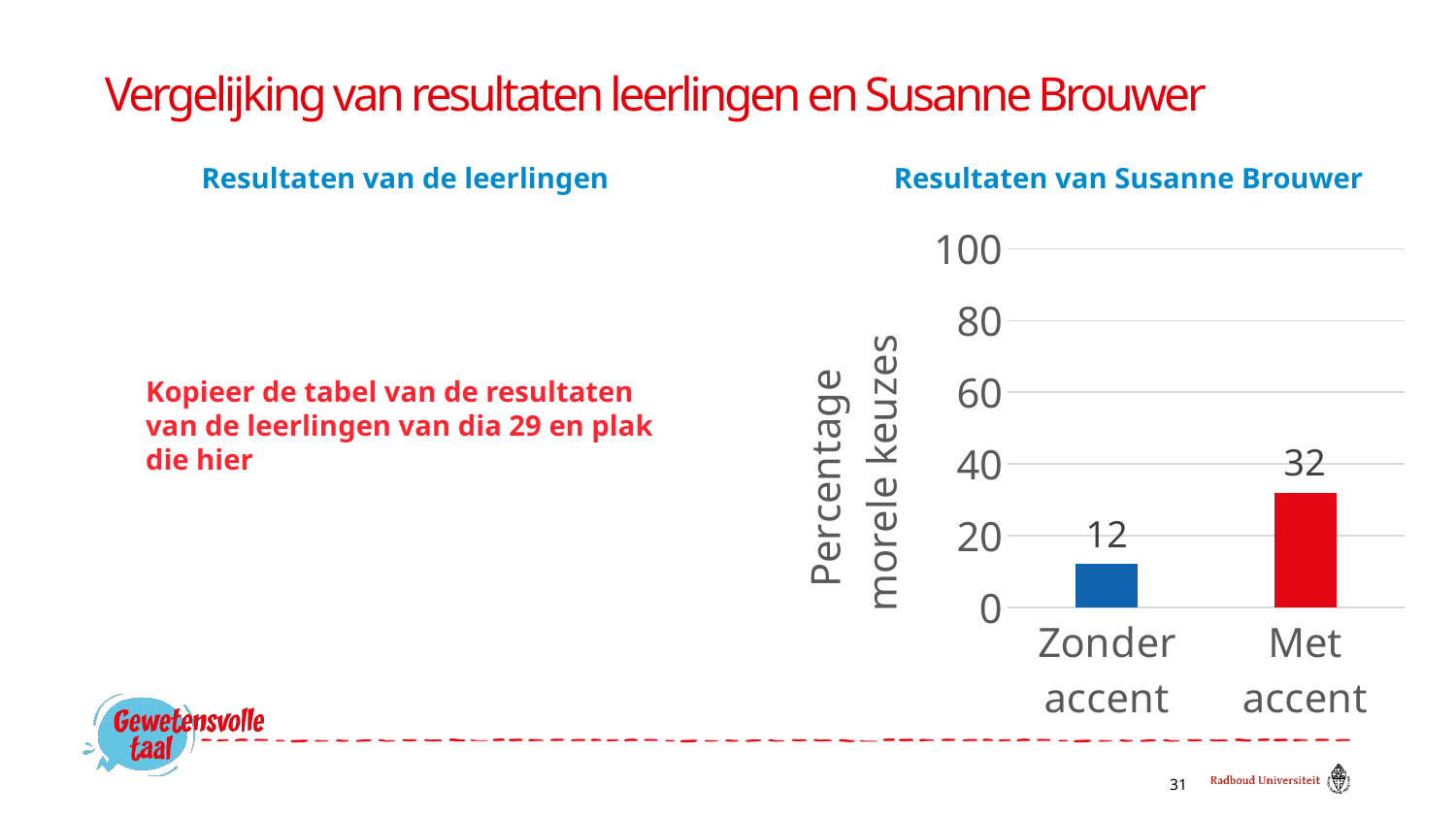
Is the value for "Met accent" greater or less than 40? less What is the label of the y axis of the chart? Percentage morele keuzes Is the value for "Zonder accent" greater or less than 20? less What kind of chart is shown on the slide? Bar chart What is the value for "Zonder accent" in the chart? 12 How many categories are shown on the x axis of the chart? 2 What is the value for "Met accent" in the chart? 32 Which is larger: the value for "Zonder accent" or the value for "Met accent"? Met accent What is the title of the chart on the slide? Resultaten van Susanne Brouwer What is the difference between the values for "Met accent" and "Zonder accent"? 20 Which category has the highest value in the chart? Met accent Which category has the lowest value in the chart? Zonder accent